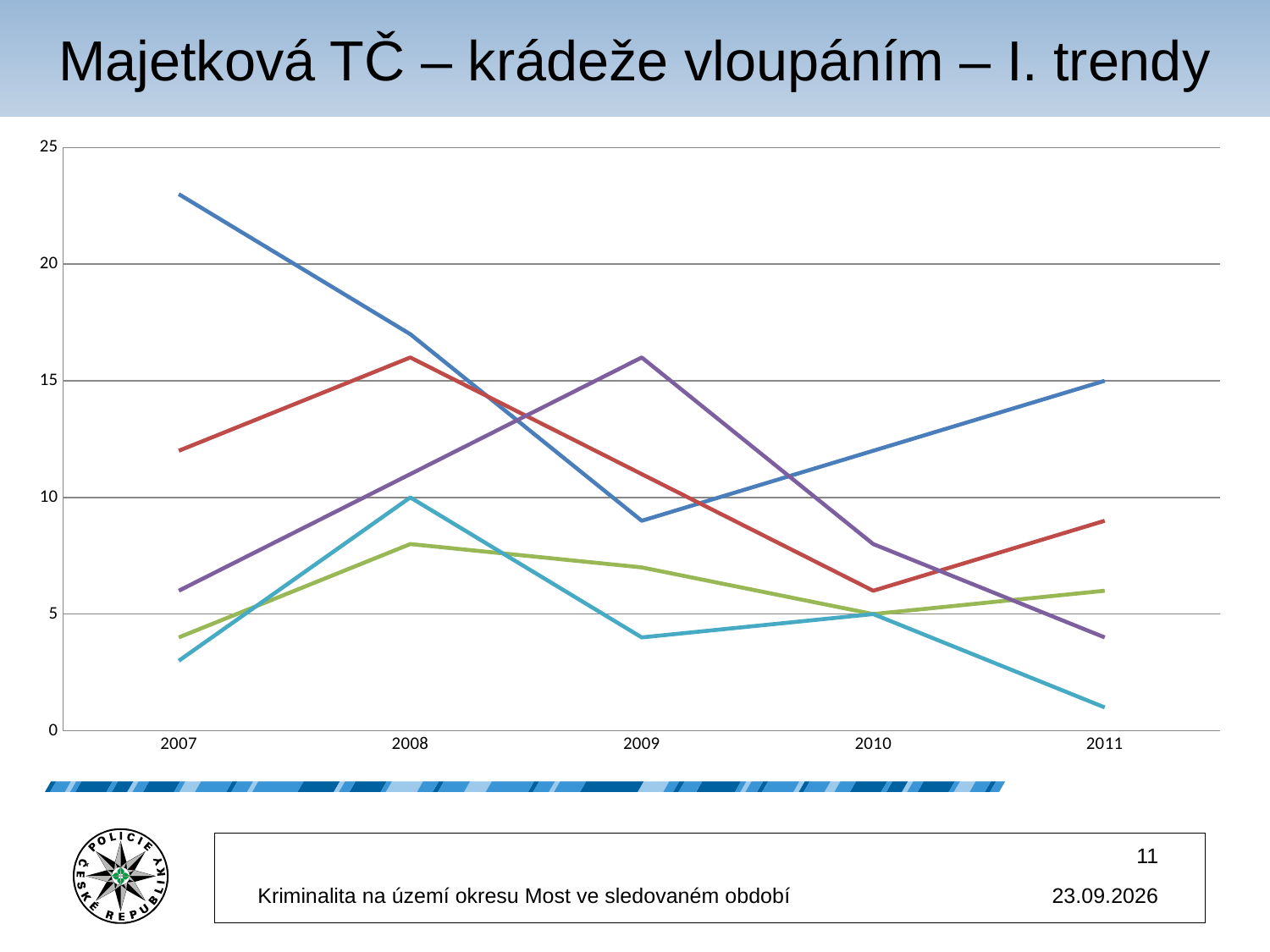
Which line has the lowest value in 2011? the light blue line Is the value of the dark blue line in 2007 greater or less than 20? greater What kind of chart is shown on the slide? line chart Is the value of the purple line in 2009 greater or less than 15? greater Does the dark blue line rise or fall from 2007 to 2009? fall How many lines are plotted on the chart? 5 Is the value of the red line in 2008 greater or less than 15? greater In 2010, which is larger: the value of the dark blue line or the value of the red line? the dark blue line How many years are shown on the x axis of the chart? 5 Which line has the highest value in 2007? the dark blue line